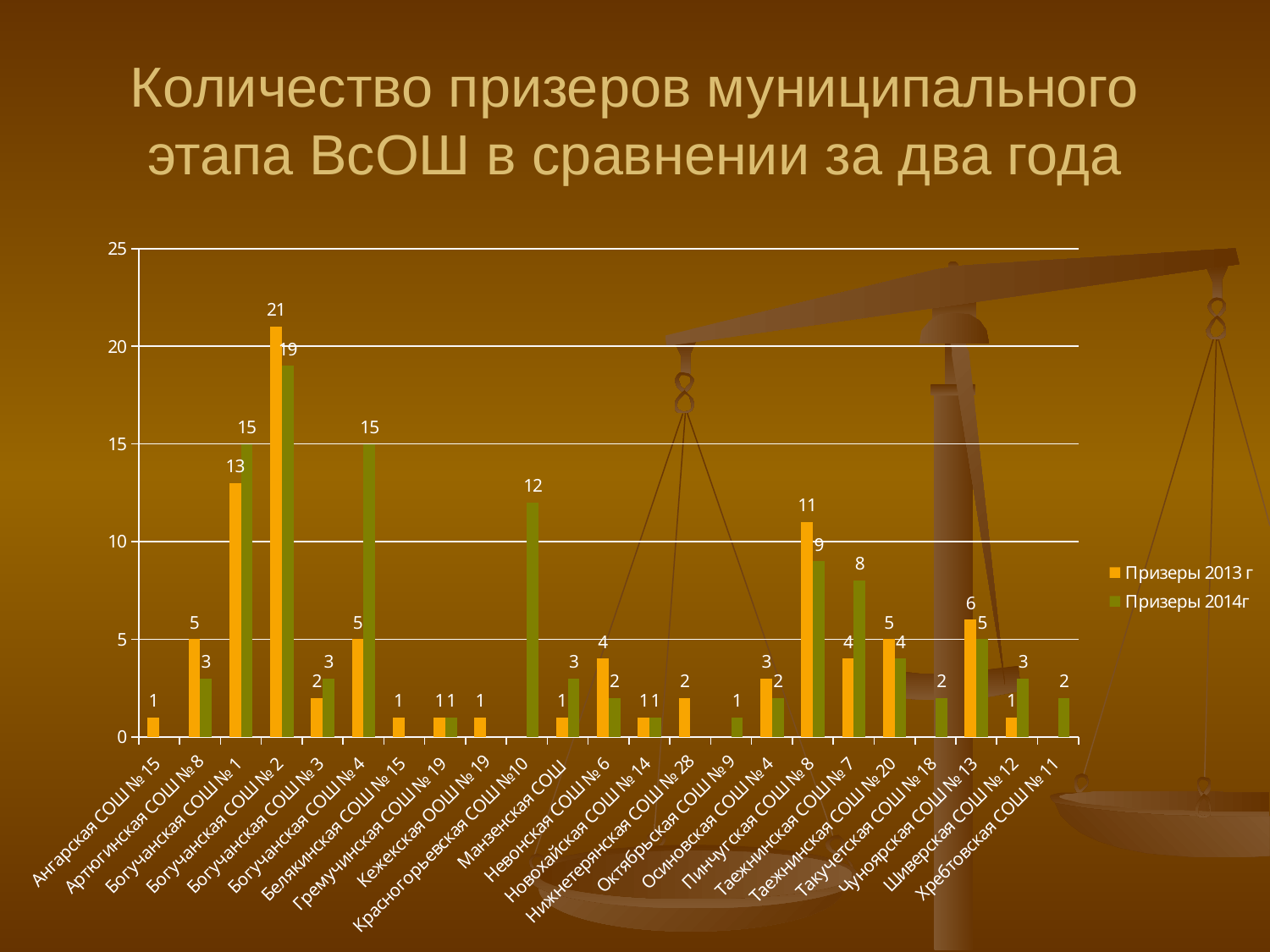
Which school has the highest value in the series Призеры 2014г? Богучанская СОШ № 2 What is the value for Красногорьевская СОШ №10 in the series Призеры 2014г? 12 What type of chart is shown on the slide? bar chart What is the title of the chart on the slide? Количество призеров муниципального этапа ВсОШ в сравнении за два года Is the value for Богучанская СОШ № 1 in the series Призеры 2013 г greater or less than 10? greater How many schools (categories) are shown on the x axis? 23 How many series does the legend list? 2 What is the difference between the 2014 and 2013 values for Богучанская СОШ № 4? 10 For Таежнинская СОШ № 7, which series has the larger value, Призеры 2013 г or Призеры 2014г? Призеры 2014г What is the value for Богучанская СОШ № 2 in the series Призеры 2013 г? 21 Which school has the highest value in the series Призеры 2013 г? Богучанская СОШ № 2 What is the value for Пинчугская СОШ № 8 in the series Призеры 2014г? 9